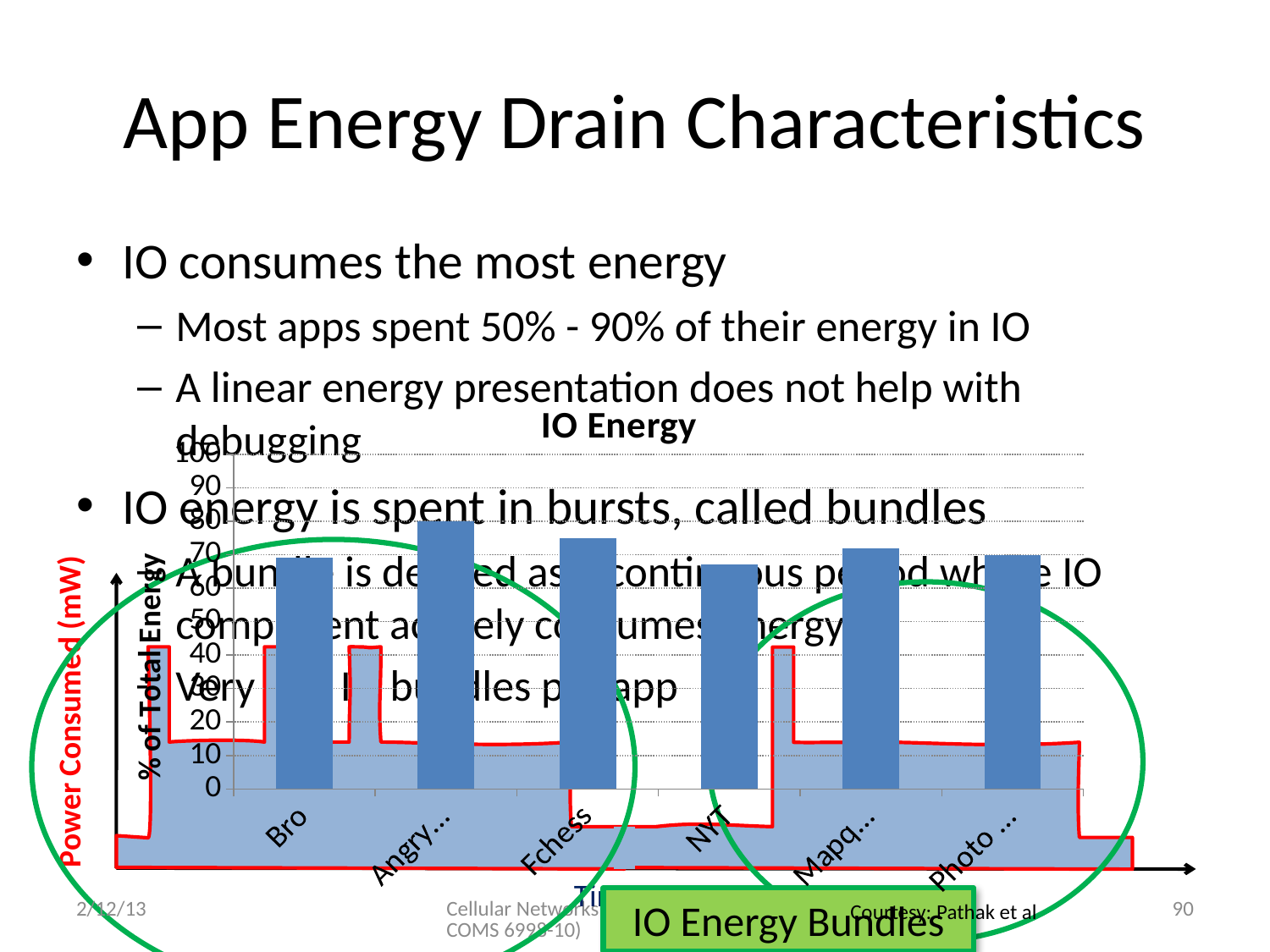
How many apps (categories) are shown on the x axis of the "IO Energy" chart? 6 In the "IO Energy" chart, is the value for Photo ... greater or less than 80? less In the "IO Energy" chart, is the value for Mapq... greater or less than 60? greater What kind of chart is the "IO Energy" chart? bar chart In the "IO Energy" chart, which is larger, the value for Fchess or the value for Bro? Fchess In the "IO Energy" chart, is the value for Angry... greater or less than 70? greater In the "IO Energy" chart, which is larger, the value for Angry... or the value for NYT? Angry... What is the title of the bar chart? IO Energy Which app has the highest bar in the "IO Energy" chart? Angry... What is the label of the vertical axis of the "IO Energy" chart? % of Total Energy